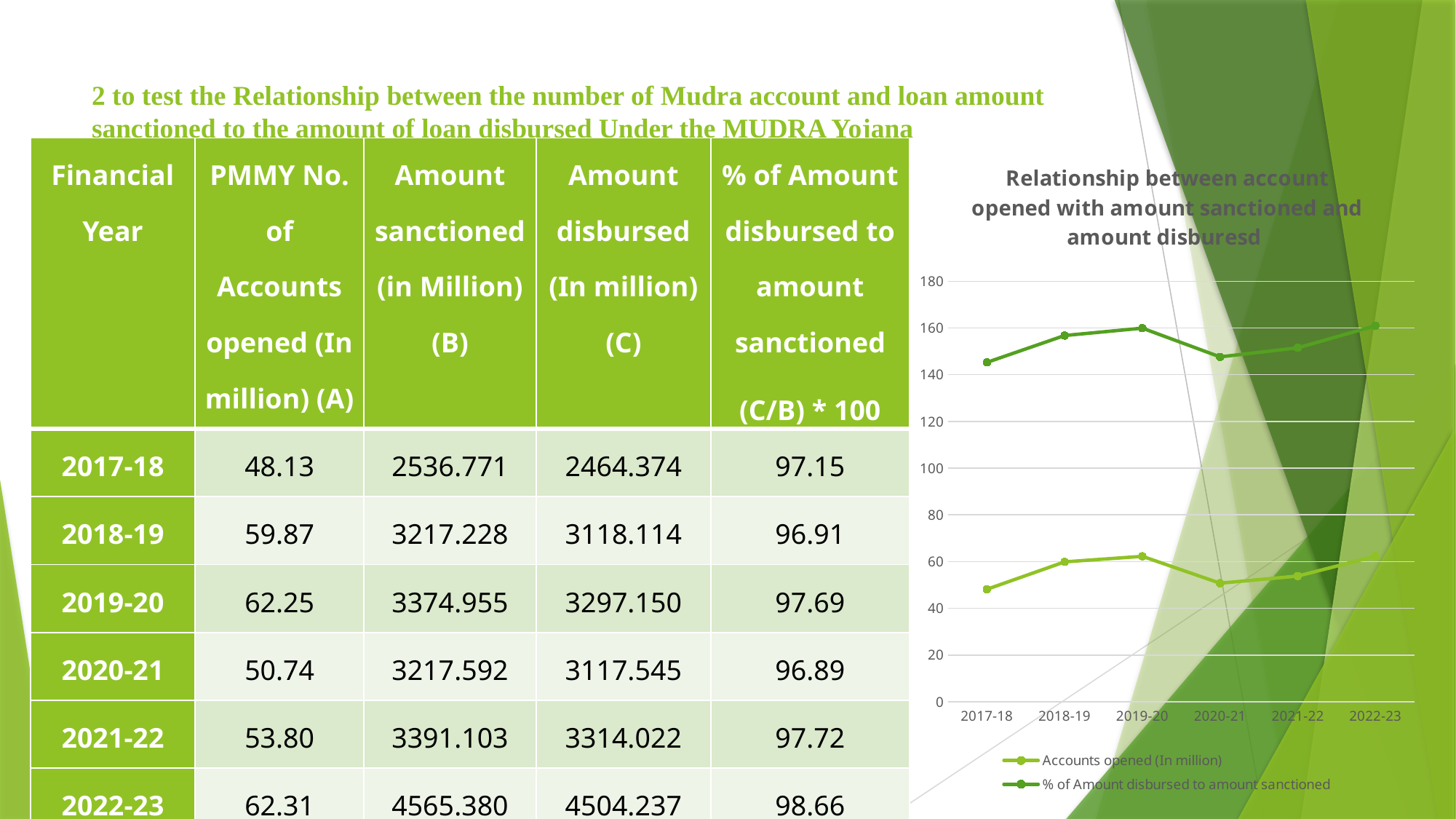
Is the value for Accounts opened (In million) in 2017-18 greater or less than 60? less Is the plotted value of the % of Amount disbursed to amount sanctioned line in 2017-18 greater or less than 140? greater Which financial year has the lowest value for Accounts opened (In million) on the chart? 2017-18 Which series is drawn in the lighter green line on the chart? Accounts opened (In million) What kind of chart is shown on the slide? line chart Is the plotted value of the % of Amount disbursed to amount sanctioned line in 2020-21 greater or less than 160? less Which is larger on the chart: Accounts opened (In million) in 2018-19 or in 2020-21? 2018-19 How many series does the chart's legend list? 2 Does the Accounts opened (In million) line rise or fall from 2019-20 to 2020-21? fall What is the title of the chart? Relationship between account opened with amount sanctioned and amount disburesd How many financial years are plotted along the x axis of the chart? 6